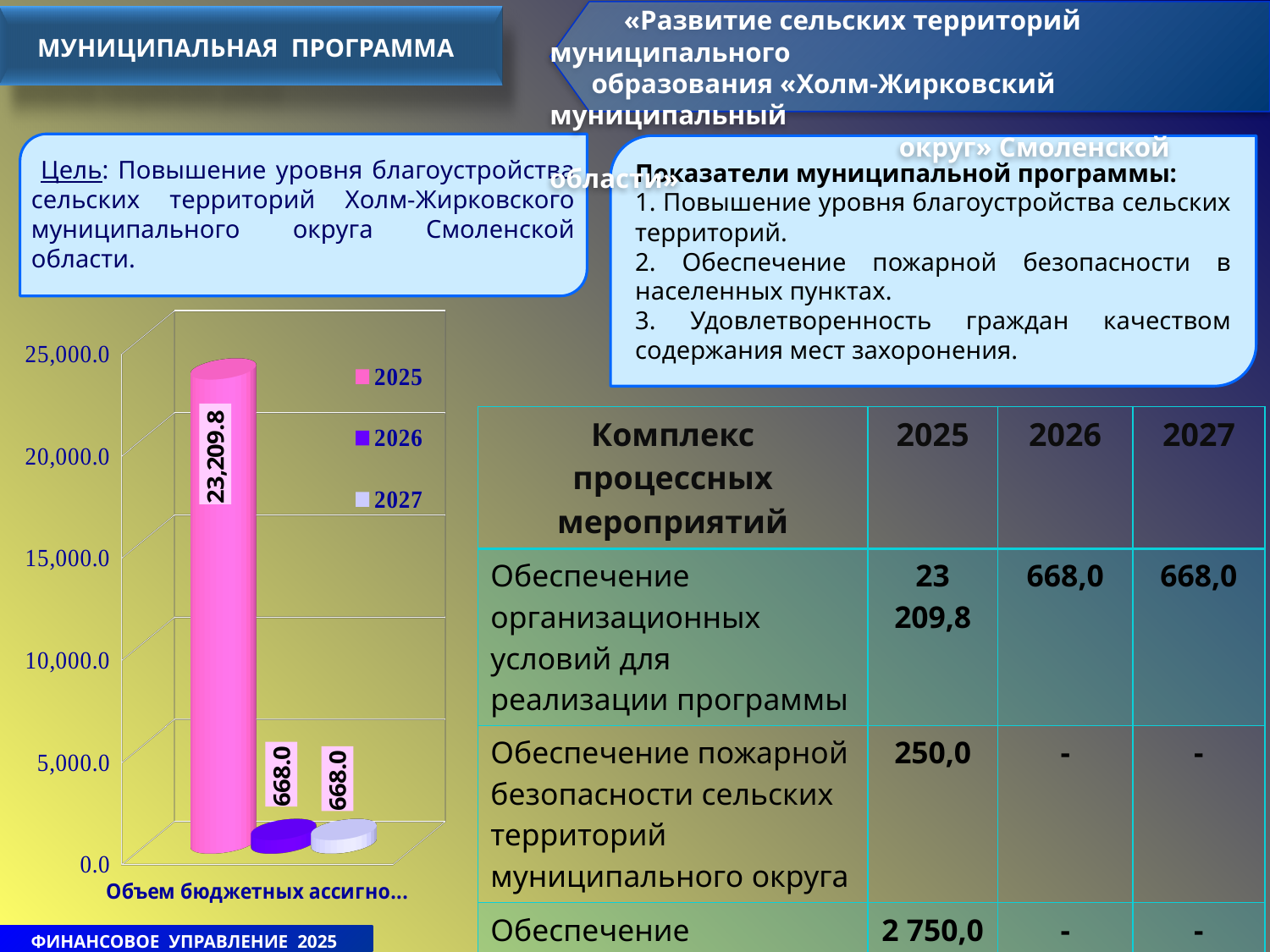
Which is larger in the chart, the value for 2025 or the value for 2027? 2025 Is the value for 2026 in the chart greater or less than 5,000.0? less What is the difference between the 2025 value and the 2026 value in the chart? 22,541.8 What is the value shown for 2027 in the chart? 668.0 What colour is the bar for 2025 in the chart? pink Is the value for 2025 in the chart greater or less than 20,000.0? greater Which year has the highest value in the chart? 2025 What is the value shown for 2025 in the chart? 23,209.8 What is the highest value labelled on the vertical axis of the chart? 25,000.0 How many series does the chart legend list? 3 What kind of chart is shown on the slide? bar chart What is the value shown for 2026 in the chart? 668.0